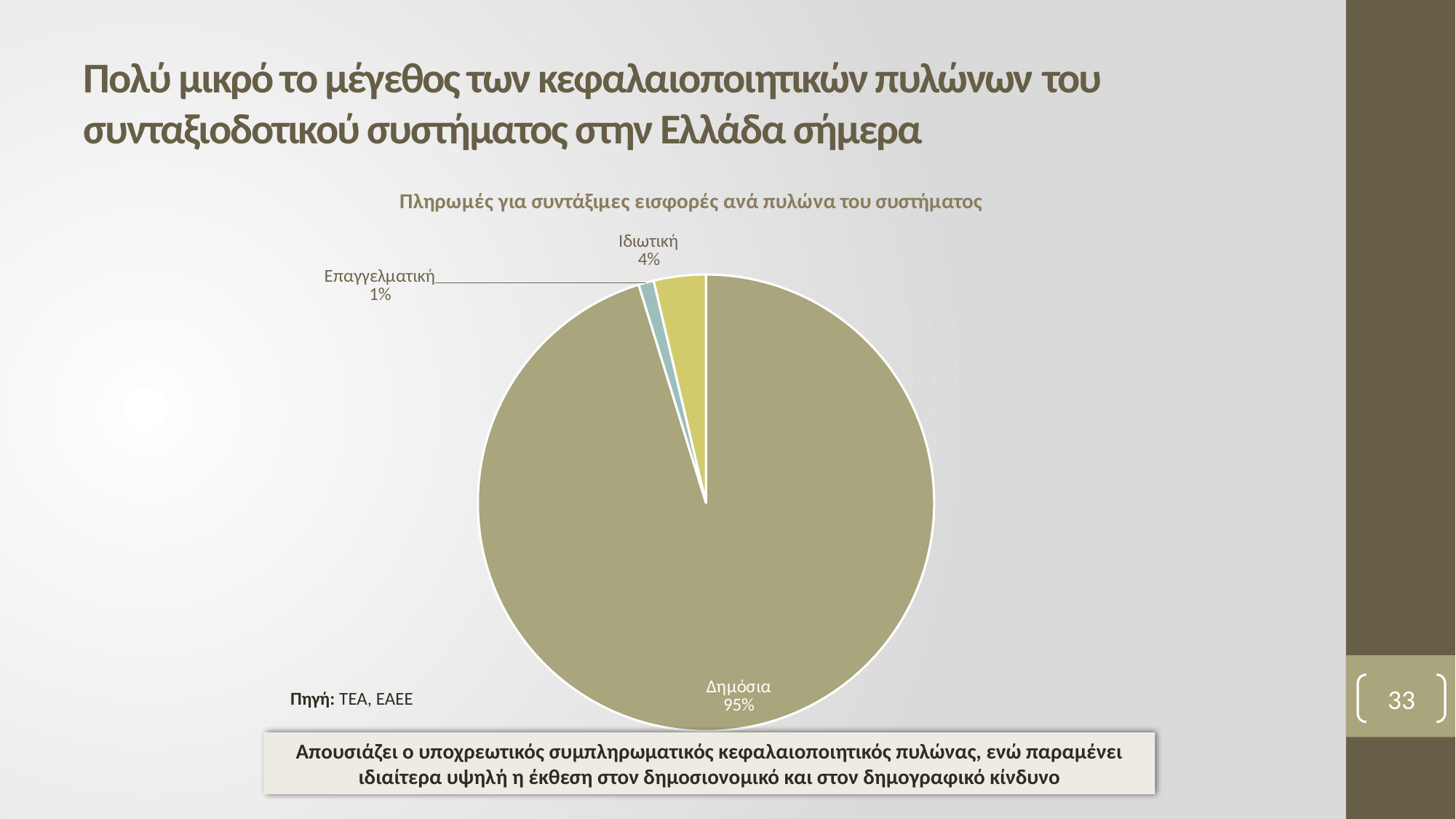
Which is larger, the share for Ιδιωτική or the share for Επαγγελματική? Ιδιωτική Which slice of the pie is the largest? Δημόσια What kind of chart is shown on the slide? pie chart What source is cited for the chart? ΤΕΑ, ΕΑΕΕ What is the share for Δημόσια? 95% What is the share for Επαγγελματική? 1% Which slice of the pie is the smallest? Επαγγελματική How many slices does the pie chart have? 3 What is the title of the chart? Πληρωμές για συντάξιμες εισφορές ανά πυλώνα του συστήματος What is the difference in percentage points between Δημόσια and Ιδιωτική? 91 What is the difference in percentage points between Ιδιωτική and Επαγγελματική? 3 What is the share for Ιδιωτική? 4%